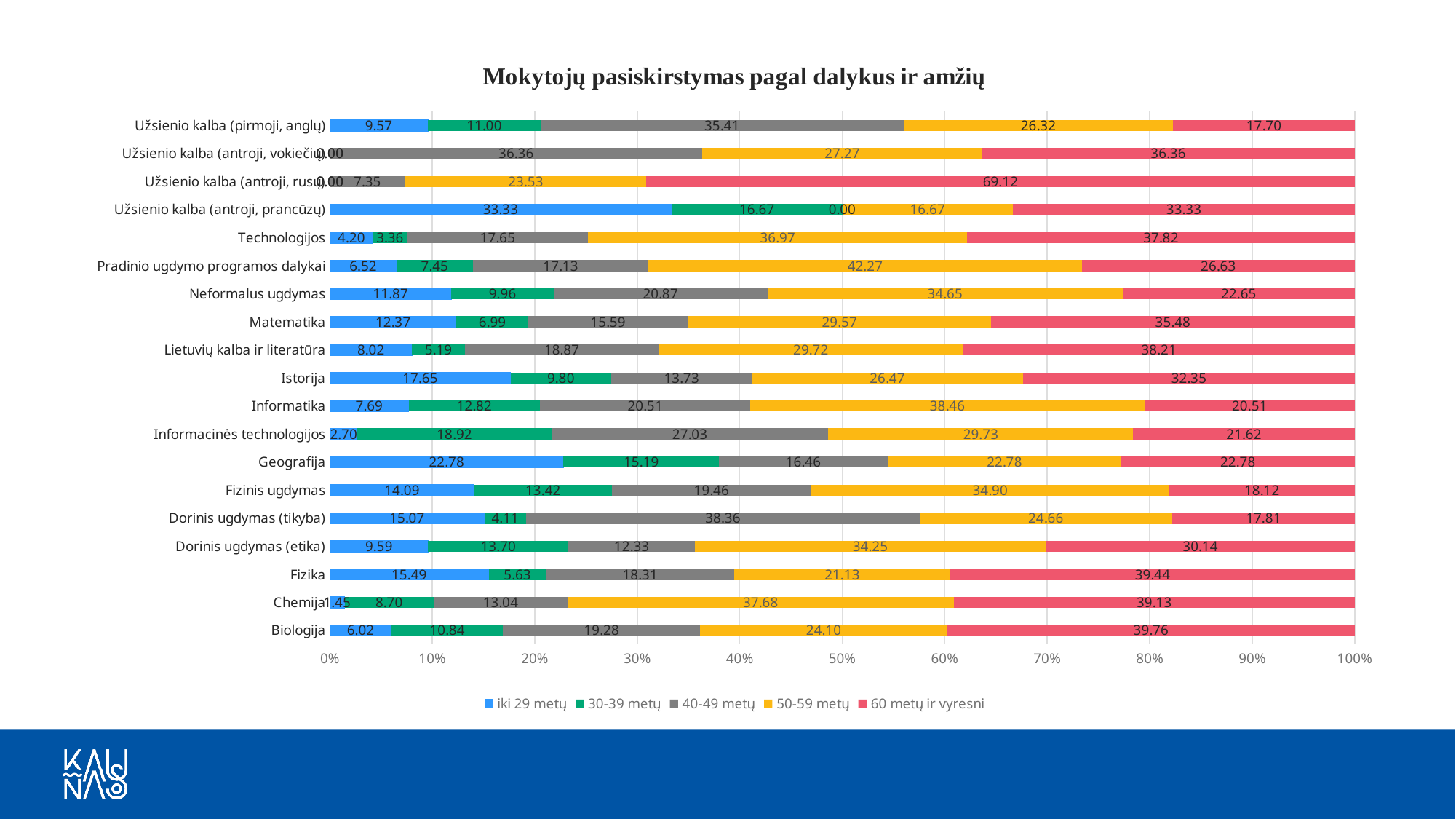
For Matematika, which is larger: the '50-59 metų' value or the '60 metų ir vyresni' value? 60 metų ir vyresni Which subject has the highest value for '50-59 metų'? Pradinio ugdymo programos dalykai How many series does the legend list? 5 What type of chart is shown on the slide? bar chart How many subject categories are plotted on the chart? 19 What is the value for '60 metų ir vyresni' for Užsienio kalba (antroji, rusų)? 69.12 For Biologija, what is the difference between the '60 metų ir vyresni' value and the 'iki 29 metų' value? 33.74 Which subject has the highest value for 'iki 29 metų'? Užsienio kalba (antroji, prancūzų) Which subject has the highest value for '60 metų ir vyresni'? Užsienio kalba (antroji, rusų) What is the value for 'iki 29 metų' for Geografija? 22.78 What is the value for '40-49 metų' for Dorinis ugdymas (tikyba)? 38.36 What is the title of the chart? Mokytojų pasiskirstymas pagal dalykus ir amžių